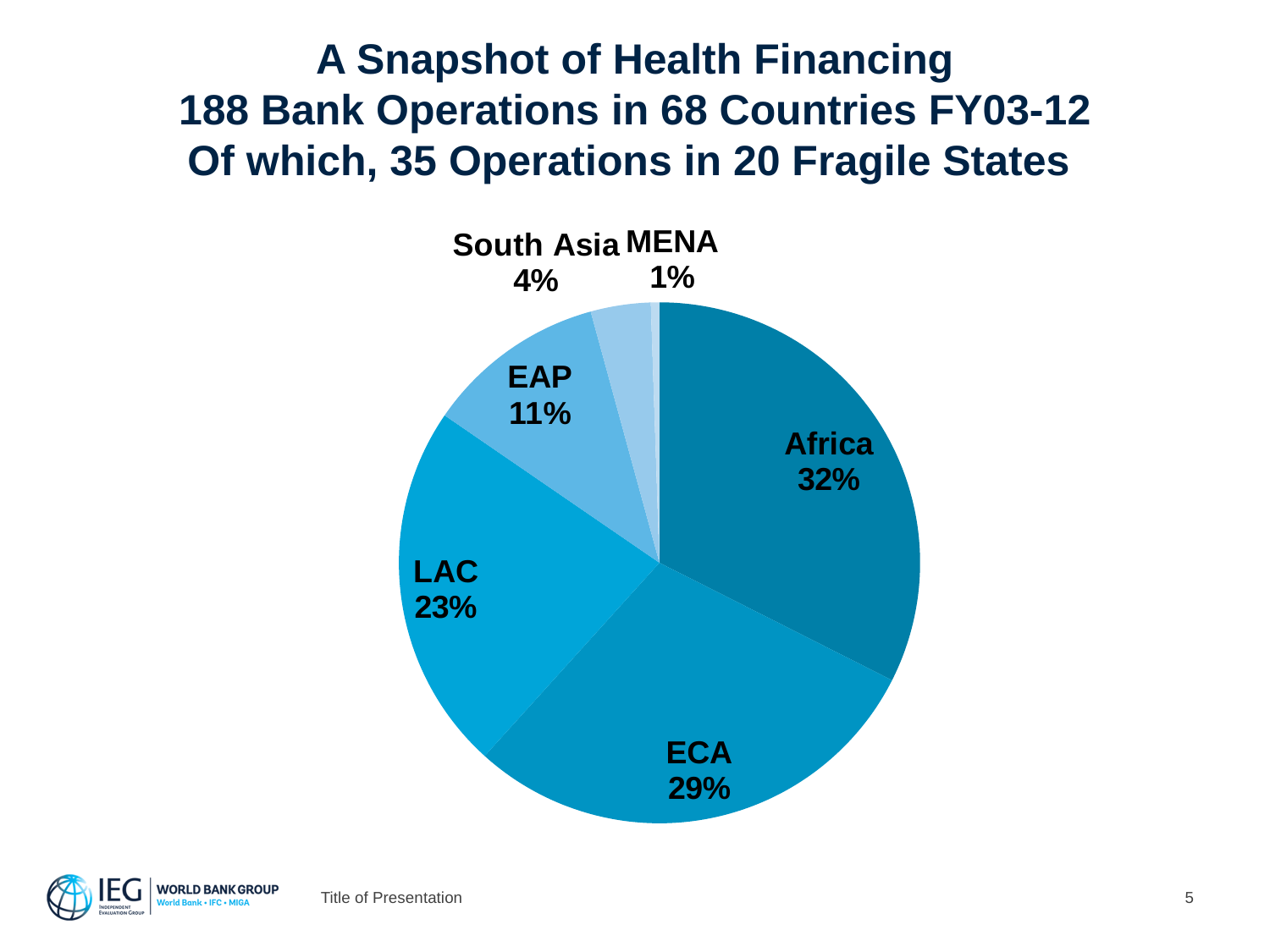
What is the difference in percentage points between Africa and ECA? 3 What is the value shown for EAP? 11% What is the difference in percentage points between LAC and EAP? 12 What kind of chart is shown on the slide? Pie chart Which region has the smallest slice of the pie? MENA What is the value shown for ECA? 29% What share of the pie does Africa account for? 32% What is the value shown for South Asia? 4% Which is larger, the share for LAC or the share for EAP? LAC What is the value shown for LAC? 23% How many regions are shown in the pie chart? 6 Which region has the largest slice of the pie? Africa